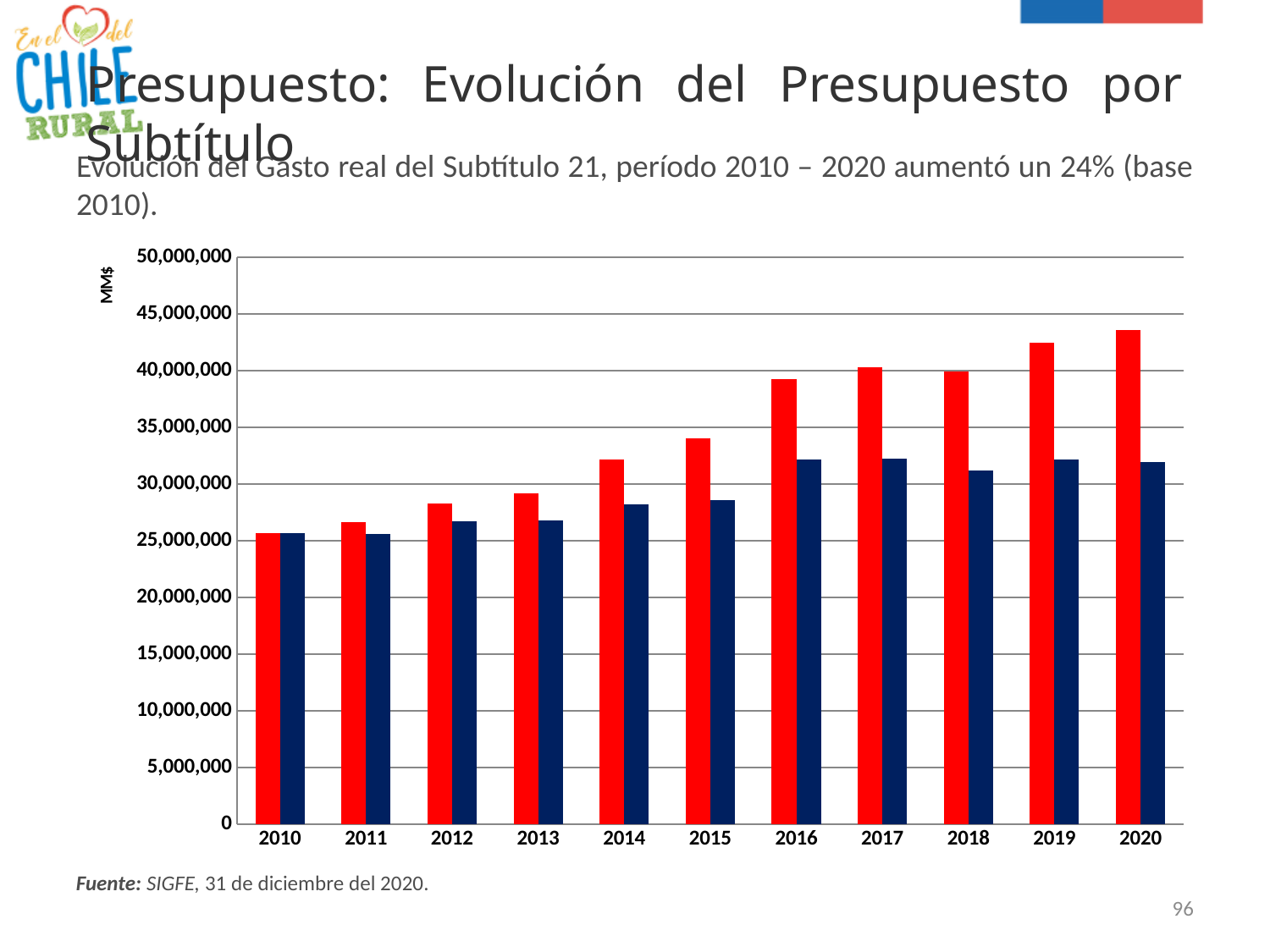
Is the value of the dark blue bar for 2013 greater or less than 30,000,000? less Do the red bars generally rise or fall from 2010 to 2020? Rise What unit label is shown on the vertical axis of the chart? MM$ Is the value of the red bar for 2020 greater or less than 40,000,000? greater Which year has the tallest red bar? 2020 Which year has the shortest red bar? 2010 How many years are shown on the x axis of the chart? 11 Is the value of the dark blue bar for 2016 greater or less than 30,000,000? greater In 2020, which bar is taller, the red bar or the dark blue bar? The red bar What type of chart is shown on the slide? Bar chart